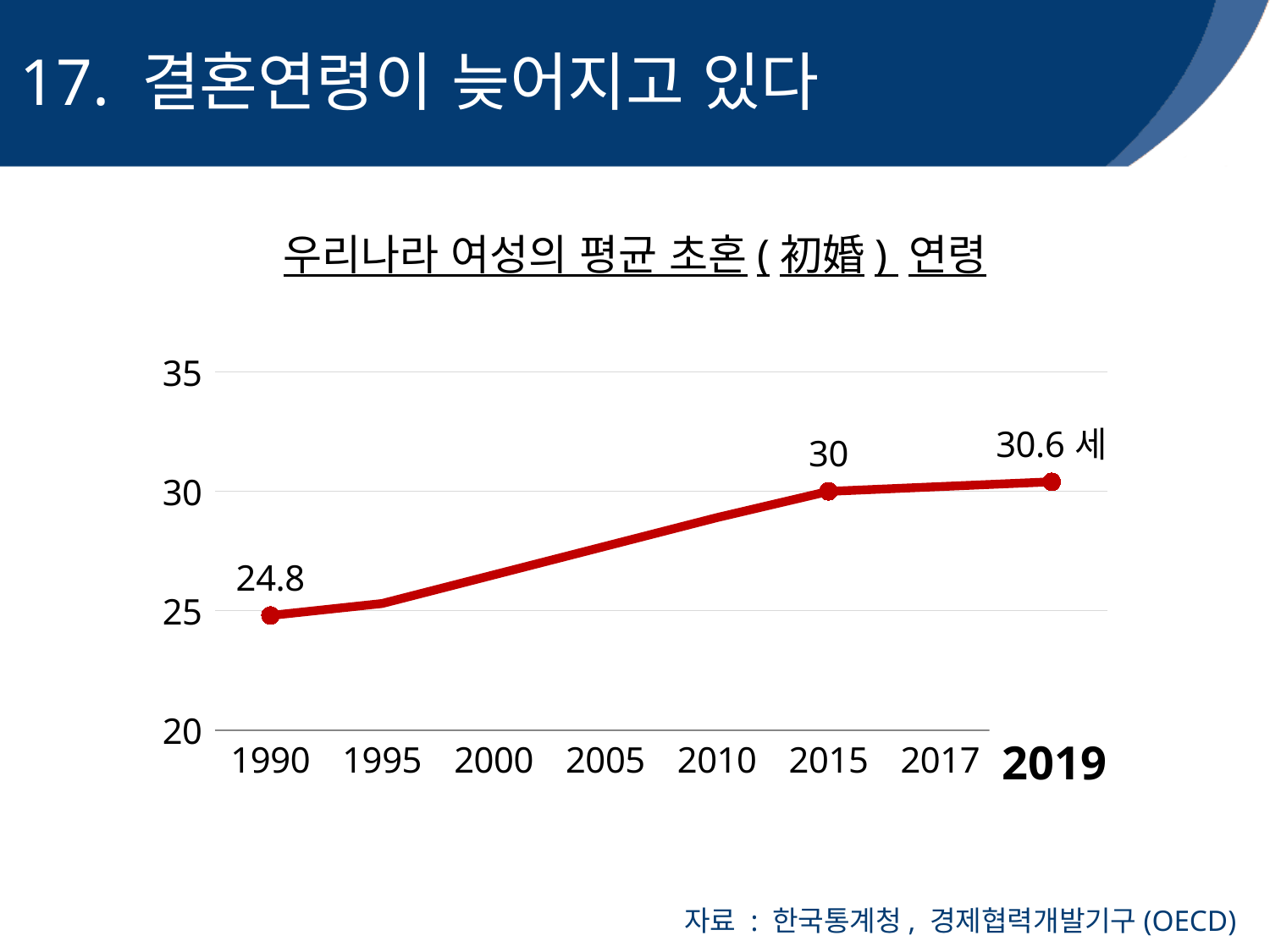
What value is labelled for 2015? 30 Is the value for 2005 greater or less than 30? less Do the values rise or fall from 1990 to 2019? rise What is the average first-marriage age shown for 1990? 24.8 What kind of chart is shown on the slide? line chart Is the value for 2010 greater or less than 25? greater By how much did the value increase from 1990 to 2019? 5.8 Which year has the lowest value on the chart? 1990 What is the difference between the 2015 value and the 1990 value? 5.2 What value is labelled for 2019? 30.6 세 How many years are labelled on the x axis? 8 Which year has the highest value on the chart? 2019